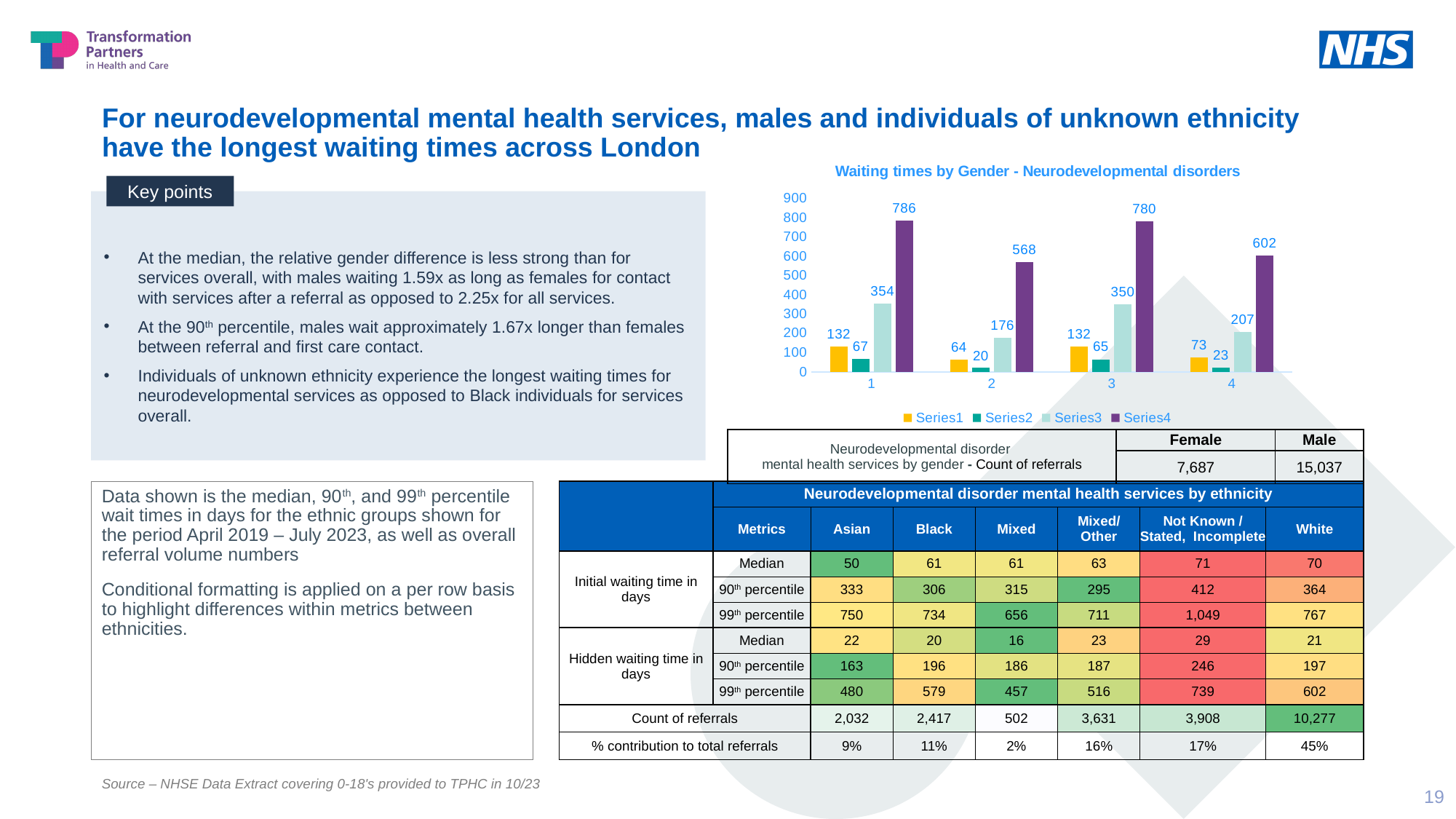
Which is larger, the Series3 value for category 1 or the Series3 value for category 3? category 1 Which category has the highest Series4 value? 1 What is the value of Series3 for category 2? 176 Which category has the lowest Series2 value? 2 What is the value of Series1 for category 4? 73 What is the difference between the Series4 values for category 1 and category 2? 218 What is the value of Series4 for category 1? 786 What is the value of Series2 for category 3? 65 What type of chart is shown on the slide? bar chart What is the title of the chart on the slide? Waiting times by Gender - Neurodevelopmental disorders How many categories are shown on the x axis of the chart? 4 How many series does the chart legend list? 4